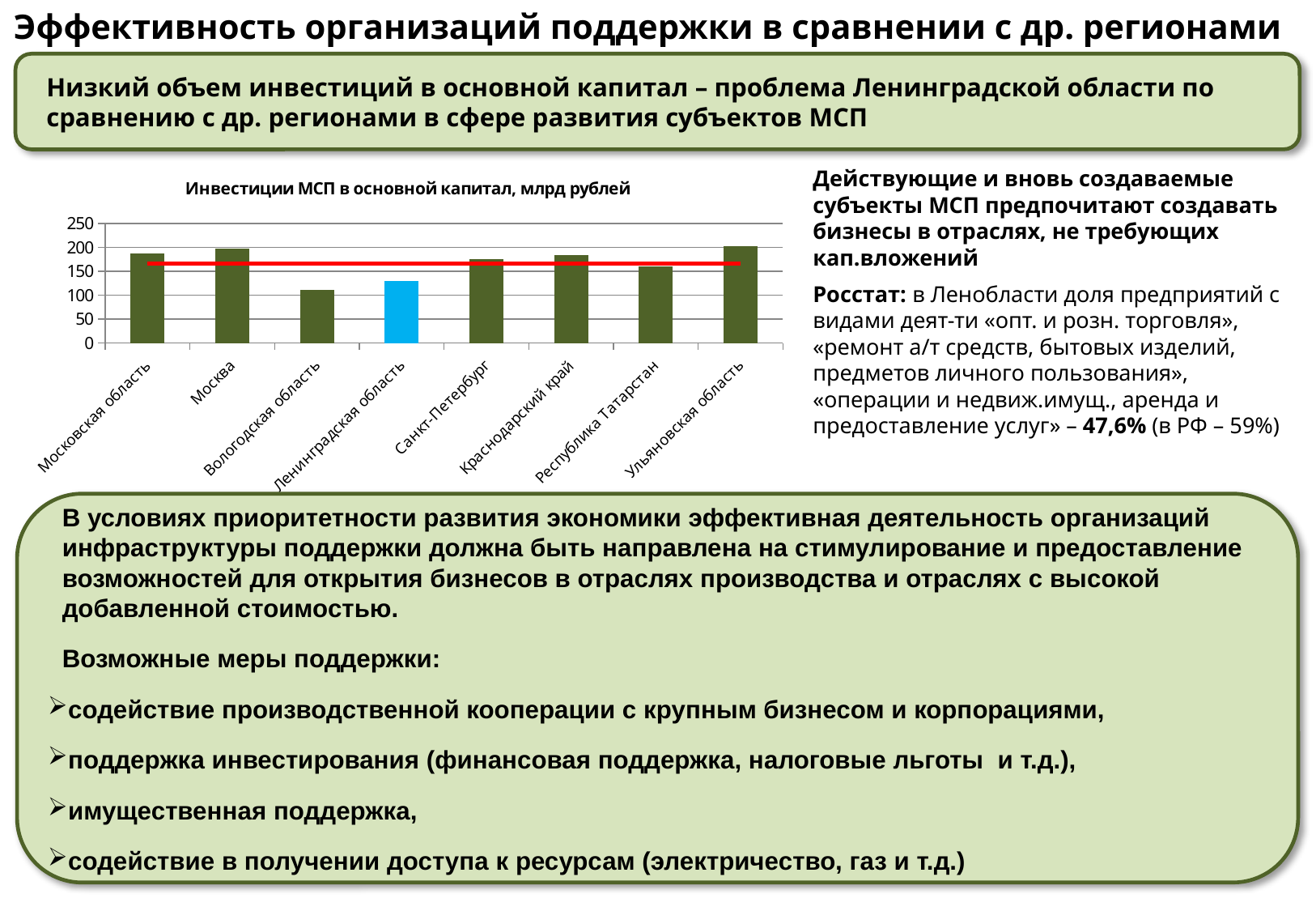
Which has the larger value, Краснодарский край or Республика Татарстан? Краснодарский край Is the value for Ульяновская область greater or less than 150? greater Which has the larger value, Ленинградская область or Вологодская область? Ленинградская область Which region has the lowest value in the chart? Вологодская область Is the value for Ленинградская область greater or less than 150? less What is the title of the chart? Инвестиции МСП в основной капитал, млрд рублей Which region's bar is coloured blue, unlike the others? Ленинградская область Which has the larger value, Москва or Вологодская область? Москва Is the value for Москва greater or less than 150? greater How many regions are shown on the x axis of the chart? 8 What type of chart is shown on the slide? Bar chart